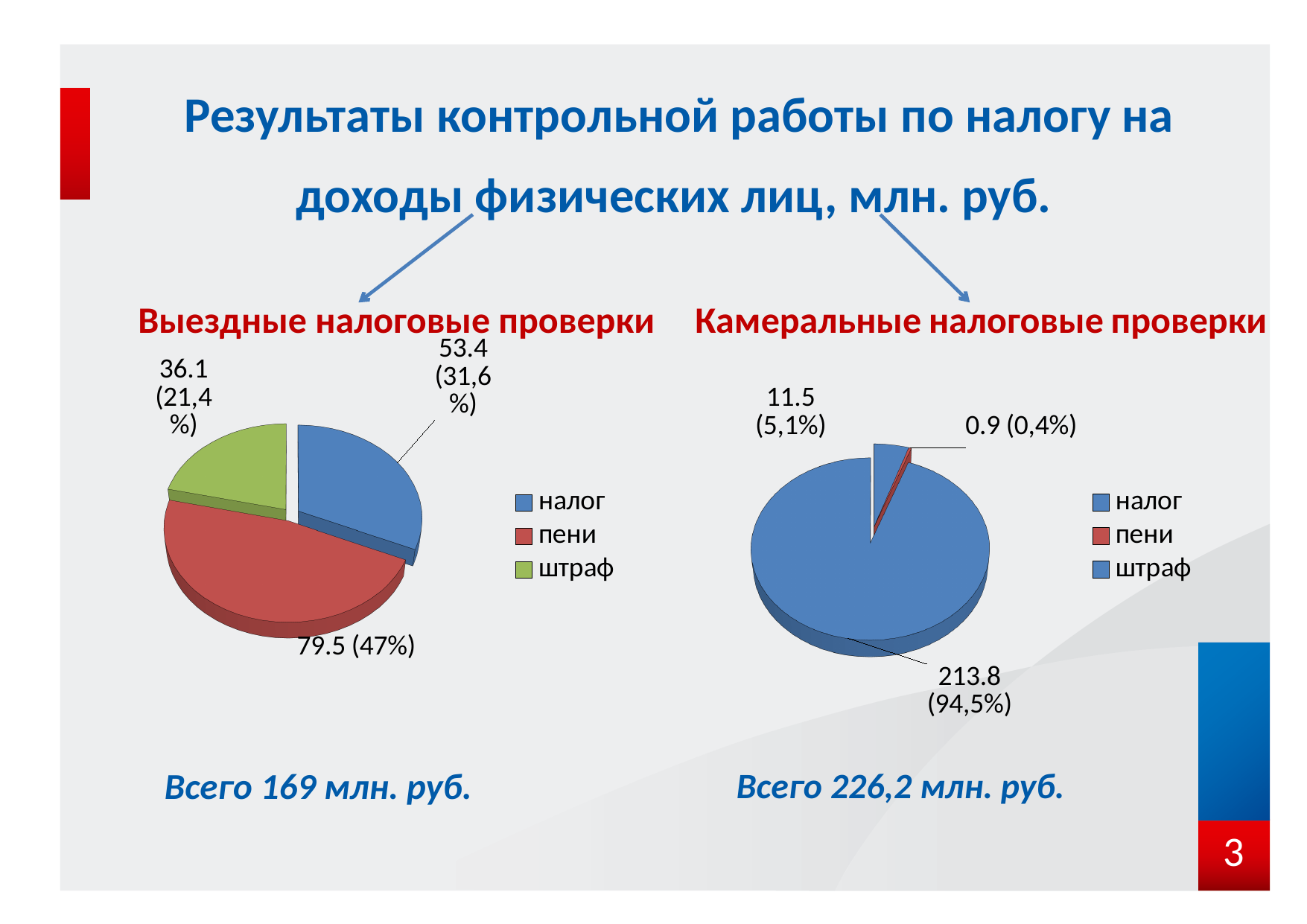
In the "Выездные налоговые проверки" chart, what is the difference between пени and налог? 26.1 In the "Выездные налоговые проверки" chart, what share of the pie does штраф take? 21,4% In the "Выездные налоговые проверки" chart, which category has the largest slice? пени In the "Выездные налоговые проверки" chart, what is the value for пени? 79.5 In the "Выездные налоговые проверки" chart, which category has the smallest slice? штраф In the "Выездные налоговые проверки" chart, what is the value for налог? 53.4 In the "Камеральные налоговые проверки" chart, which category has the smallest slice? пени What type of chart is used for "Выездные налоговые проверки"? pie chart How many entries does the legend of the "Камеральные налоговые проверки" chart list? 3 In the "Камеральные налоговые проверки" chart, which is larger, штраф or пени? штраф